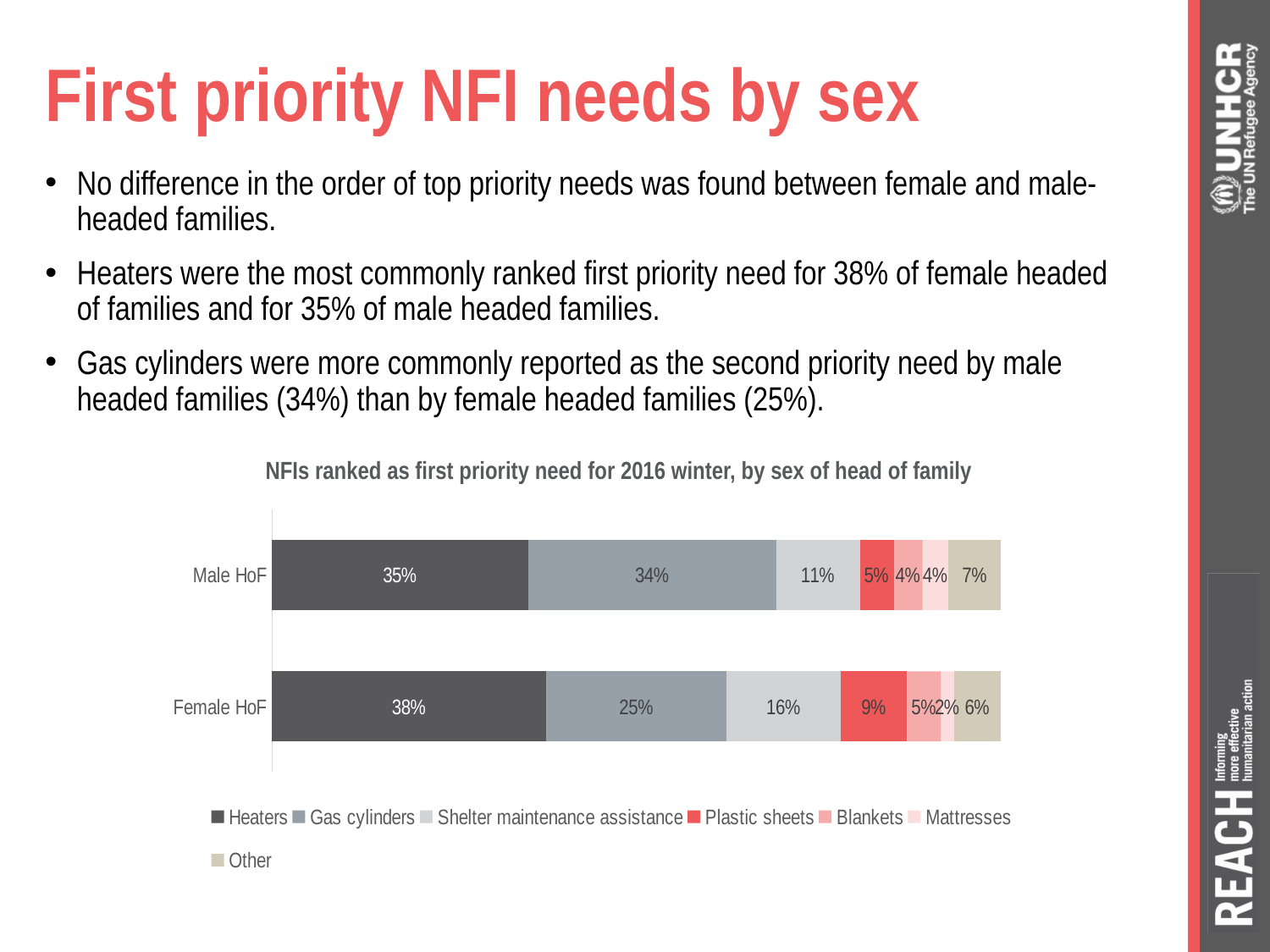
What is the value for Shelter maintenance assistance for Female HoF? 16% Which series has the largest share of the Male HoF bar? Heaters How many categories (bars) are shown in the chart? 2 How many series does the chart legend list? 7 What is the title of the chart? NFIs ranked as first priority need for 2016 winter, by sex of head of family Which category has the higher value for Gas cylinders, Male HoF or Female HoF? Male HoF What is the total of the labelled segments in the Male HoF bar? 100% What percentage of Female HoF ranked Gas cylinders as the first priority need? 25% What is the difference between the Heaters values for Female HoF and Male HoF? 3% What is the value for Plastic sheets for Male HoF? 5% What percentage of Male HoF ranked Heaters as the first priority need? 35% What kind of chart is shown on the slide? Stacked bar chart